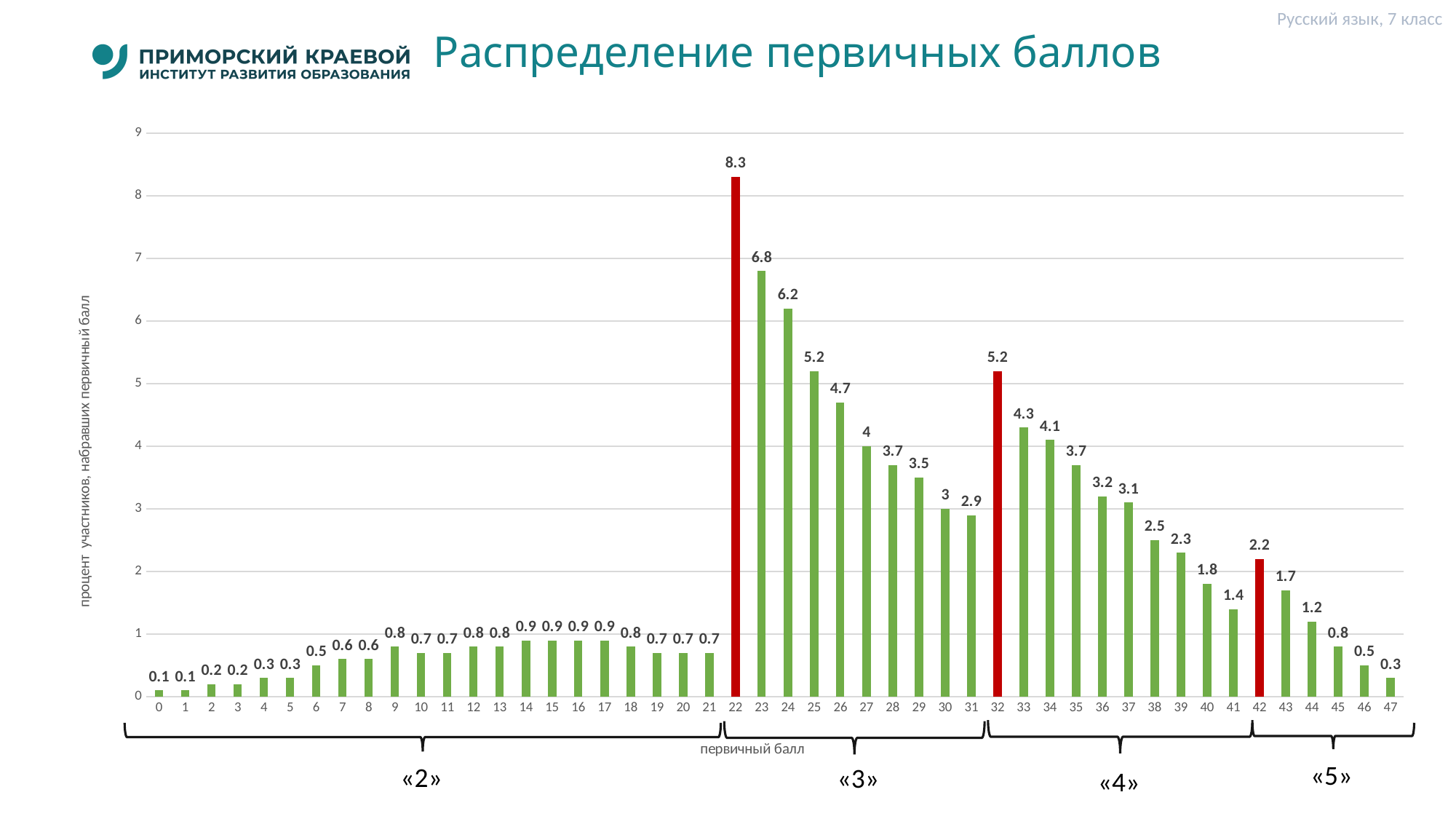
What is the value for primary score 32? 5.2 What is the value for primary score 22? 8.3 What is the title of the chart? Распределение первичных баллов What is the value for primary score 42? 2.2 Which is larger, the value for primary score 25 or the value for primary score 33? 25 How many primary score categories are shown on the x axis? 48 Which primary score has the highest percentage of participants? 22 What is the value for primary score 47? 0.3 Do the values rise or fall from primary score 22 to primary score 31? fall Is the value for primary score 24 greater or less than 6? greater What type of chart is shown on the slide? bar chart What is the difference between the values for primary scores 22 and 23? 1.5